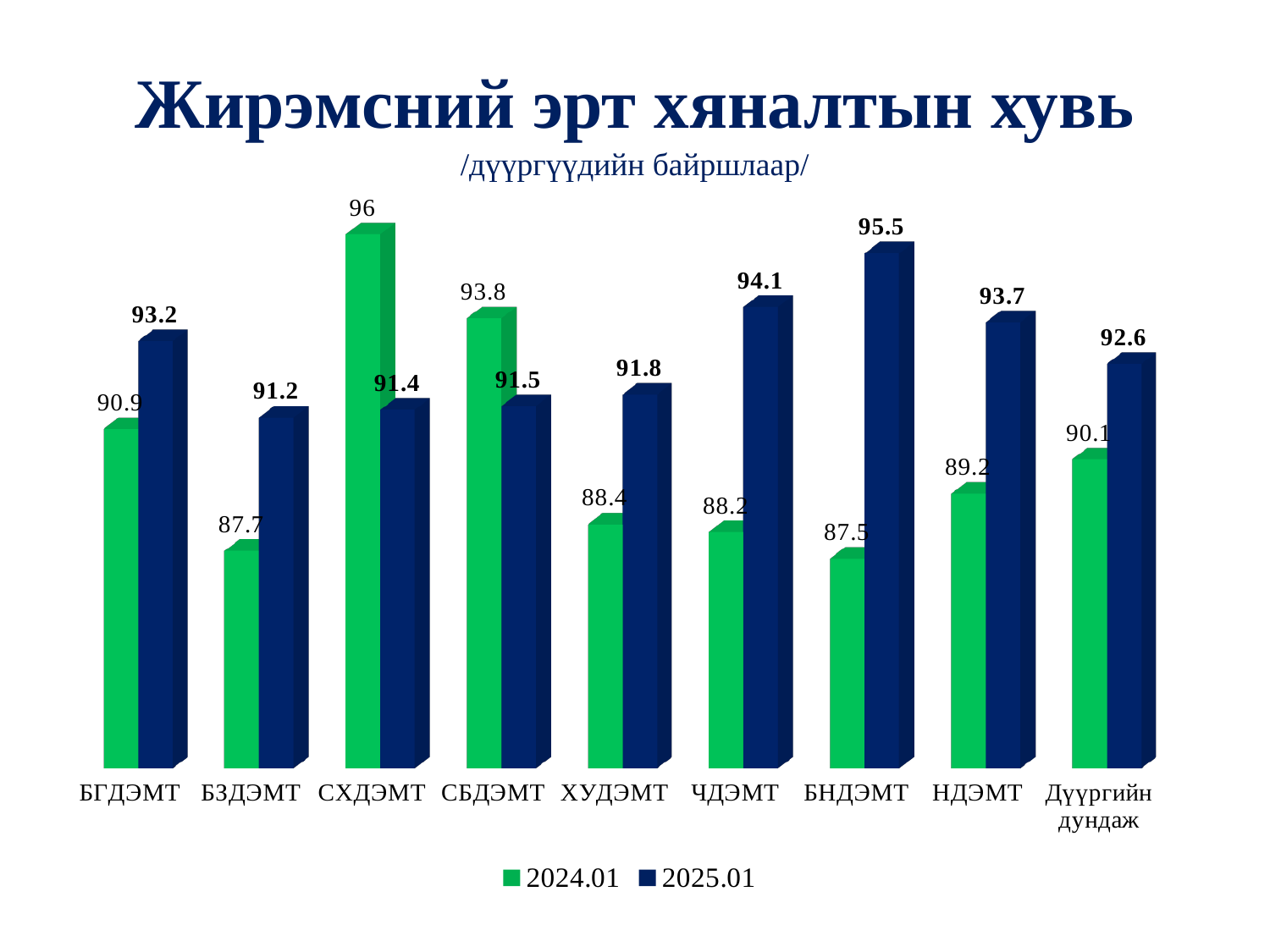
Which is larger for СБДЭМТ: the 2024.01 value or the 2025.01 value? 2024.01 Which category has the highest 2025.01 value? БНДЭМТ What kind of chart is shown on the slide? Bar chart What is the difference between the 2025.01 and 2024.01 values for БНДЭМТ? 8 What is the difference between the 2024.01 and 2025.01 values for СХДЭМТ? 4.6 What is the 2024.01 value for БЗДЭМТ? 87.7 What is the 2025.01 value for БНДЭМТ? 95.5 What is the 2025.01 value for Дүүргийн дундаж? 92.6 How many categories are shown on the x axis? 9 What is the 2024.01 value for СХДЭМТ? 96 How many series does the legend list? 2 Which category has the lowest 2024.01 value? БНДЭМТ